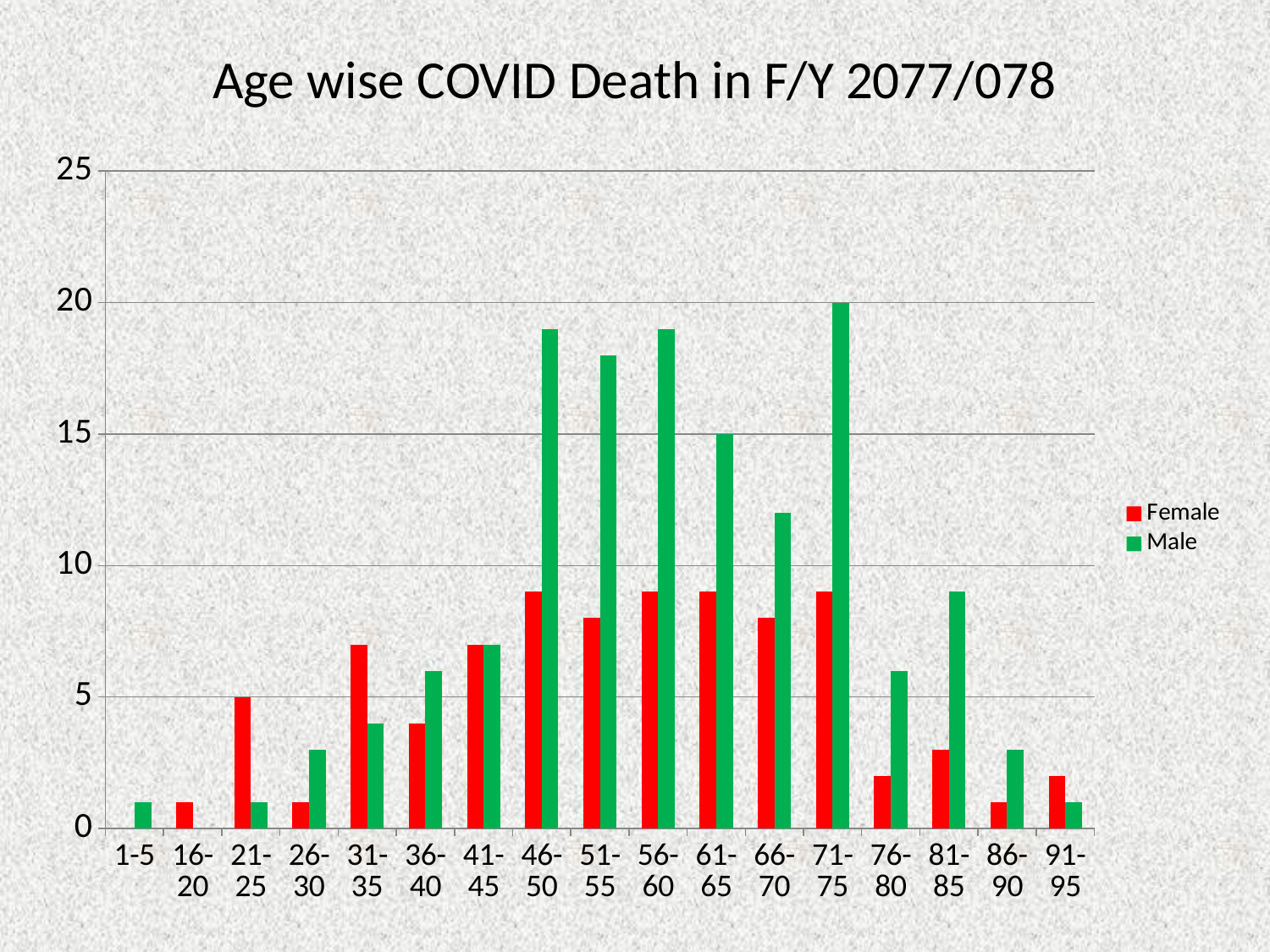
Is the Male value for the 46-50 age group greater or less than 15? greater What is the Male value for the 61-65 age group? 15 Which colour represents the Female series in the legend? Red Which age group has the highest Male value? 71-75 What is the Female value for the 21-25 age group? 5 What is the title of the chart? Age wise COVID Death in F/Y 2077/078 In the 46-50 age group, which is larger, the Female value or the Male value? Male Is the Female value for the 76-80 age group greater or less than 5? less What is the Male value for the 71-75 age group? 20 What type of chart is shown on the slide? Bar chart How many series does the legend list? 2 How many age-group categories are shown on the x axis? 17